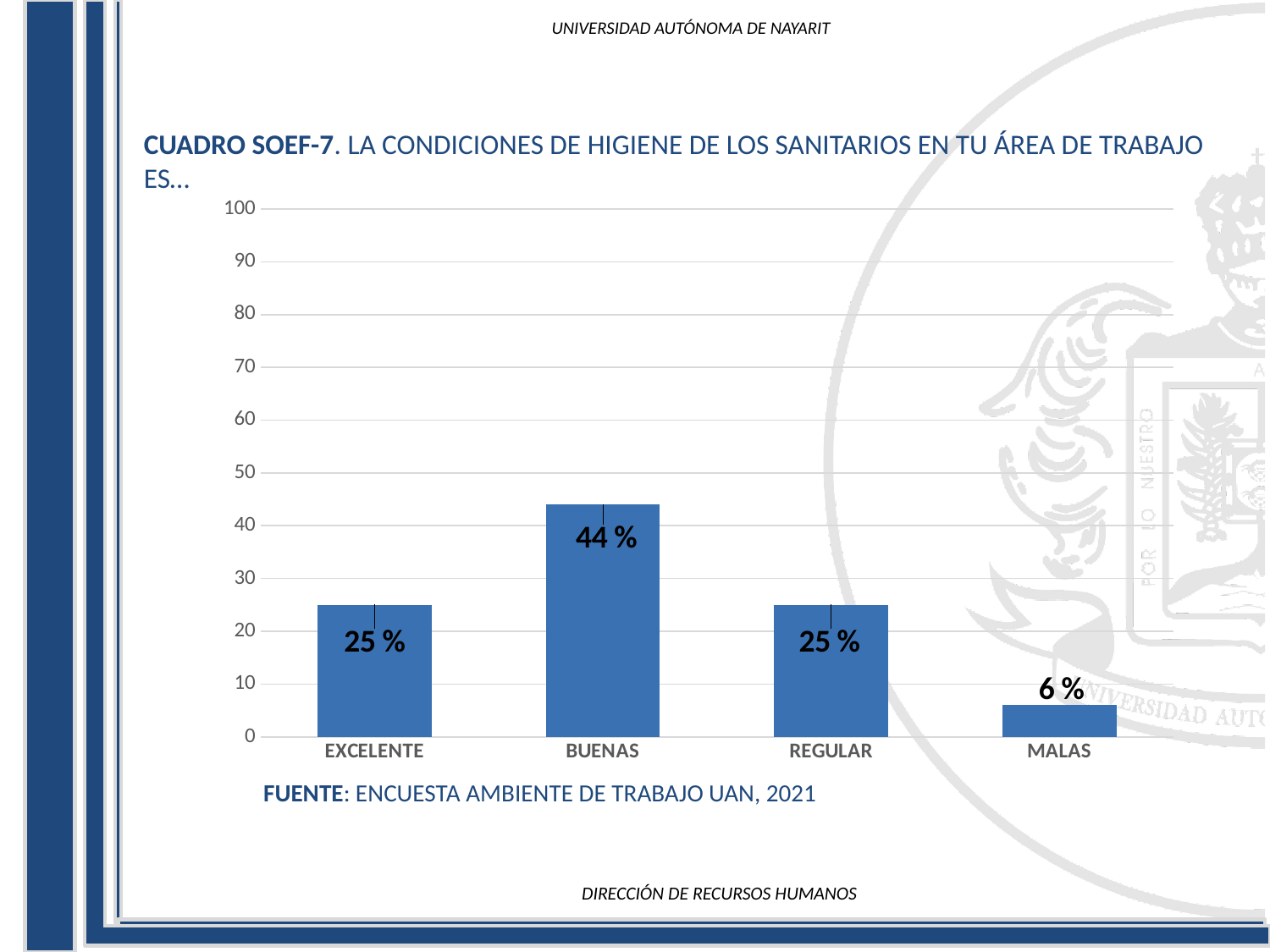
What is the value for MALAS? 6 % Which category has the lowest value? MALAS Which is larger, the value for BUENAS or the value for MALAS? BUENAS What is the value for BUENAS? 44 % How many categories are shown on the x axis? 4 Is the value for MALAS greater or less than 10? less What source is cited below the chart? ENCUESTA AMBIENTE DE TRABAJO UAN, 2021 Is the value for BUENAS greater or less than 40? greater Which category has the highest value? BUENAS What is the difference between the values for BUENAS and REGULAR? 19 % What is the value for EXCELENTE? 25 % What kind of chart is shown on the slide? bar chart